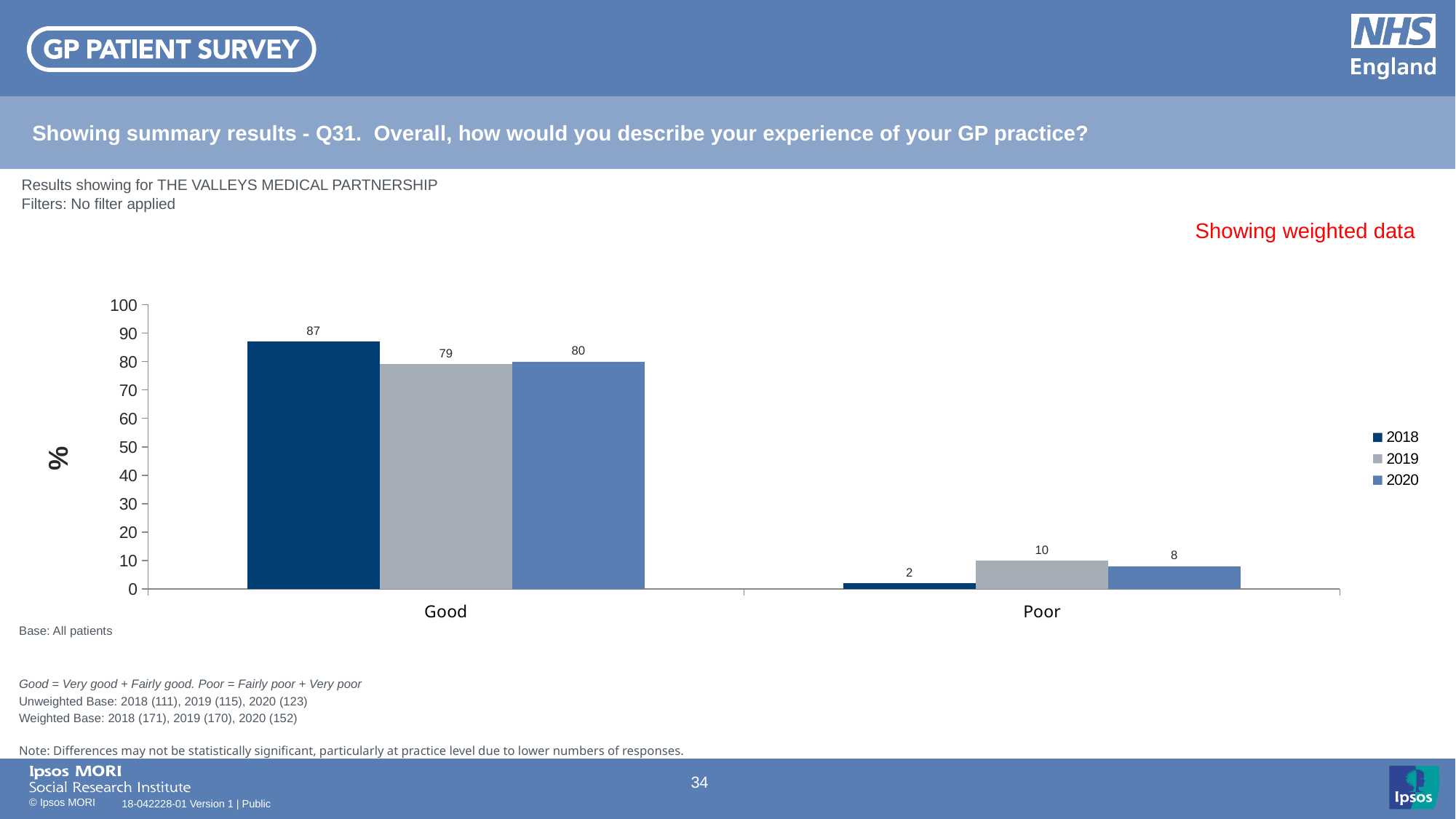
Which year has the lowest value in the Poor category? 2018 What kind of chart is shown on the slide? bar chart How many series does the legend list? 3 Which is larger in the Poor category, the 2019 value or the 2020 value? 2019 What is the value for 2018 in the Good category? 87 Is the value for 2020 in the Poor category greater or less than 10? less What is the difference between the 2018 and 2019 values in the Good category? 8 What is the value for 2019 in the Poor category? 10 How many categories are shown on the x axis? 2 What is the value for 2020 in the Good category? 80 What label is shown on the y axis? % Which year has the highest value in the Good category? 2018